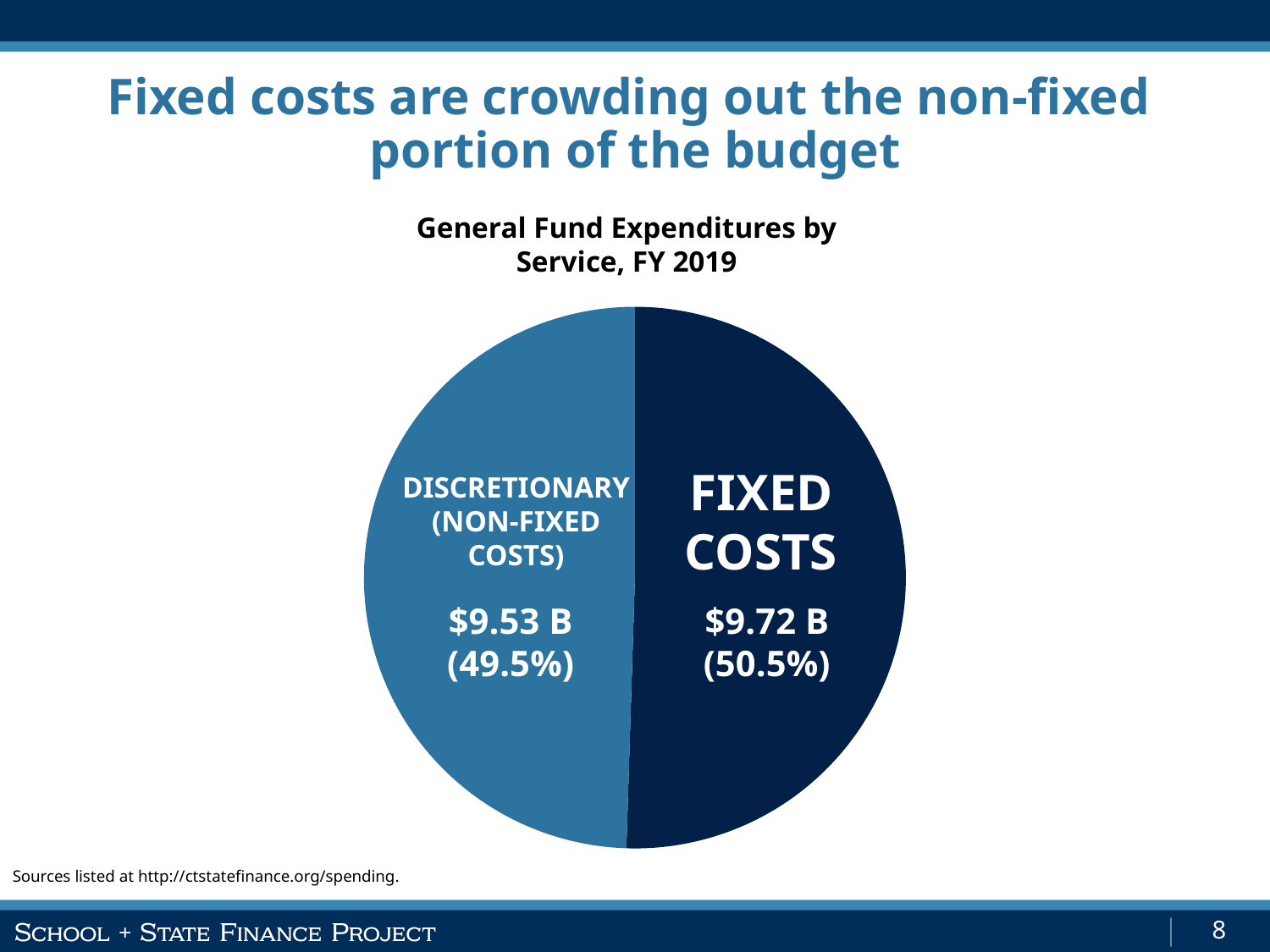
What is the dollar value shown for Discretionary (Non-Fixed Costs)? $9.53 B What type of chart is shown on the slide? pie chart Which slice is shown in the darker navy colour? Fixed Costs What is the difference in dollars between Fixed Costs and Discretionary (Non-Fixed Costs)? $0.19 B Which category has the smallest share of the pie? Discretionary (Non-Fixed Costs) What share of General Fund expenditures is Discretionary (Non-Fixed Costs)? 49.5% What is the combined total of the two slices in dollars? $19.25 B What is the dollar value shown for Fixed Costs? $9.72 B Which slice is larger, Fixed Costs or Discretionary (Non-Fixed Costs)? Fixed Costs What share of General Fund expenditures is Fixed Costs? 50.5% How many slices does the pie chart have? 2 What is the title of the chart? General Fund Expenditures by Service, FY 2019